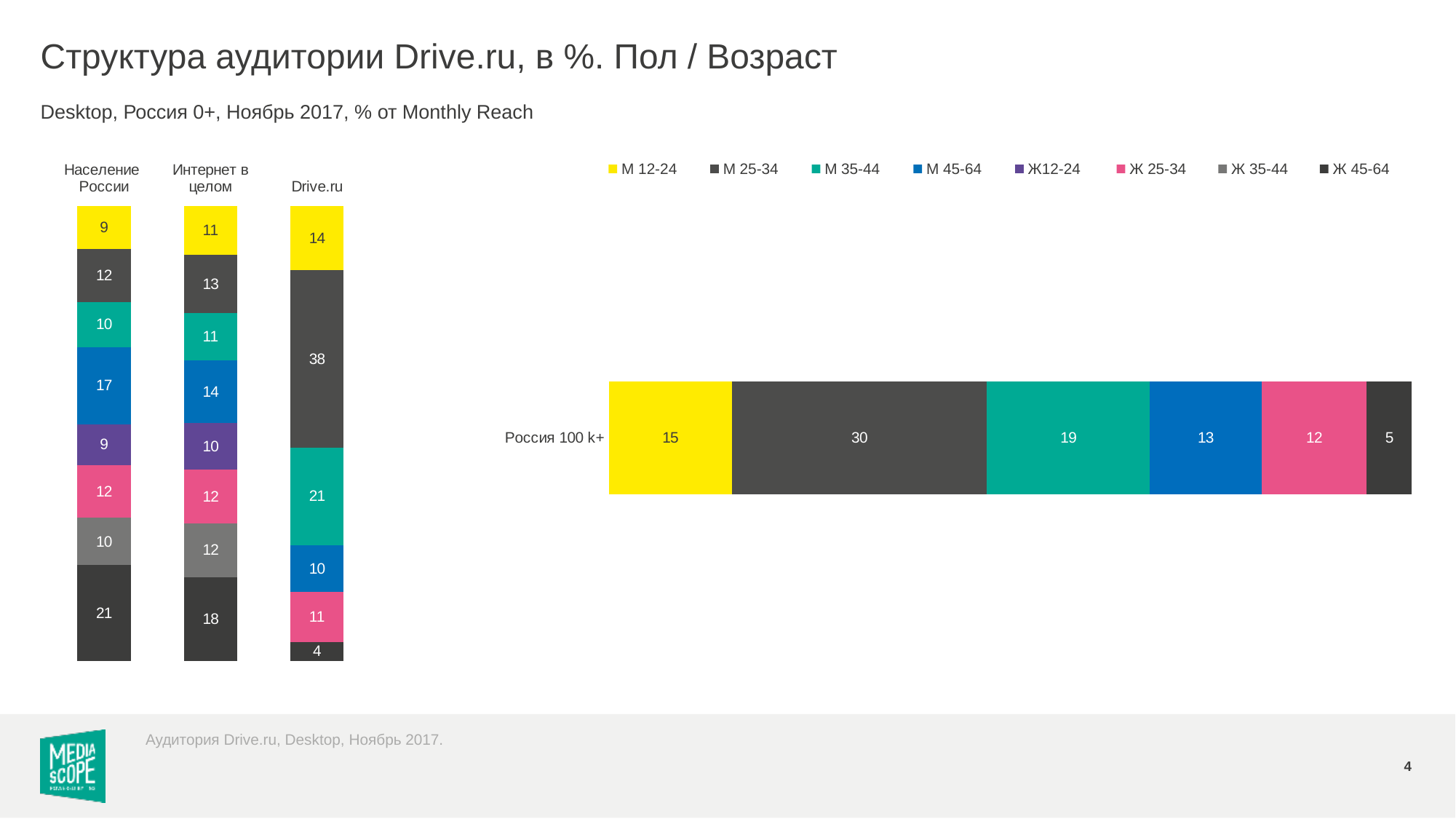
In the right chart (Россия 100 k+), what is the value of the yellow М 12-24 segment? 15 How many series does the legend on the right list? 8 How many bars does the left chart contain? 3 In the left chart, which is larger: the М 45-64 value for Население России or for Drive.ru? Население России In the right chart, what is the total of all segments in the Россия 100 k+ bar? 94 In the right chart (Россия 100 k+), what is the value of the teal М 35-44 segment? 19 What type of chart is the right chart (Россия 100 k+)? Stacked bar chart In the left chart, what is the value of the bottom (Ж 45-64) segment for Население России? 21 In the left chart, what is the value of the М 25-34 (dark grey) segment for Drive.ru? 38 In the left chart, what is the difference between the М 25-34 value for Drive.ru and for Интернет в целом? 25 In the left chart, which segment of the Drive.ru bar has the largest value? М 25-34 In the left chart, which segment of the Drive.ru bar has the smallest value? Ж 45-64